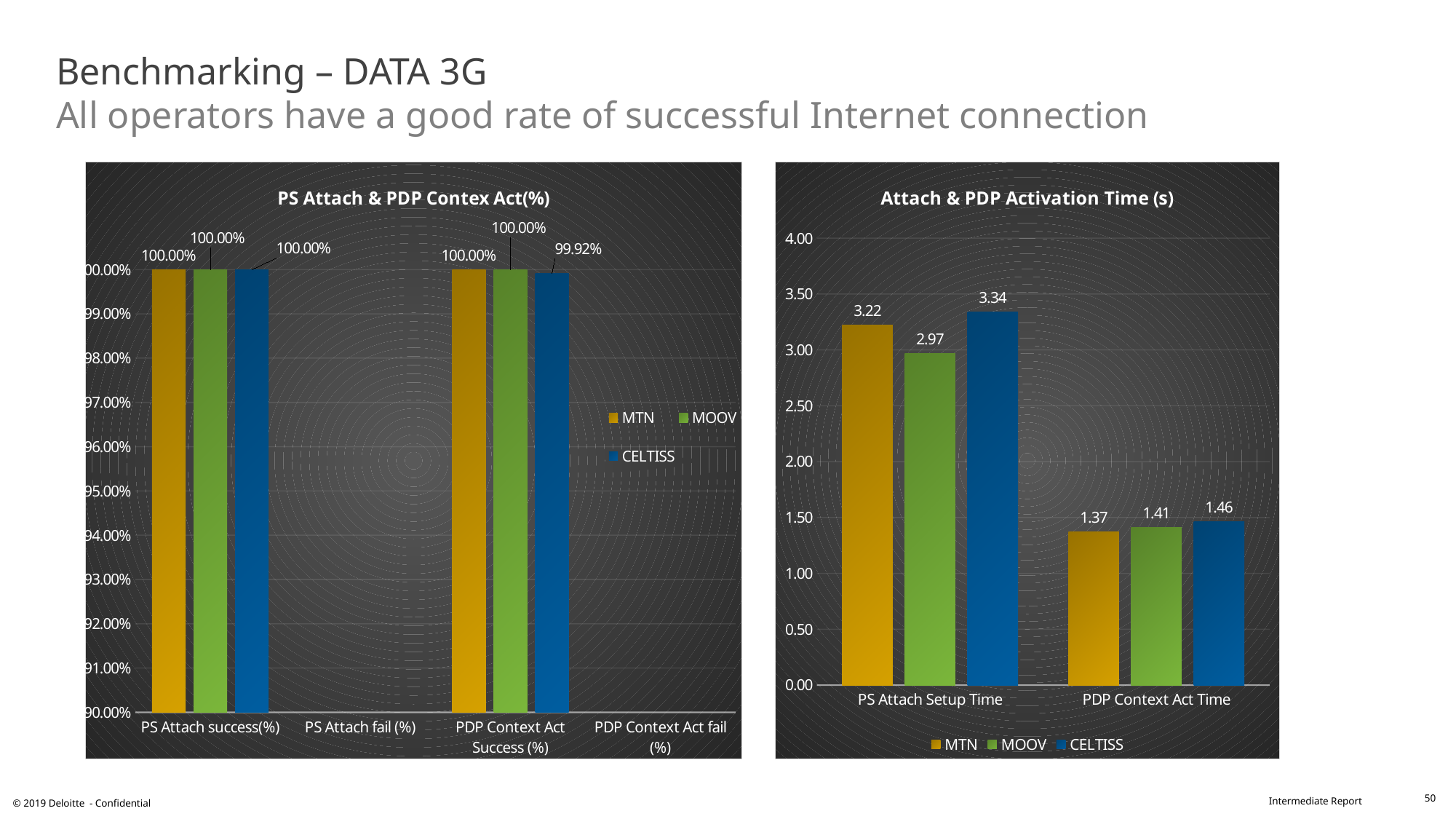
In the 'Attach & PDP Activation Time (s)' chart, which operator has the highest PS Attach Setup Time? CELTISS In the 'PS Attach & PDP Contex Act(%)' chart, what is the PS Attach success(%) value for MTN? 100.00% In the 'Attach & PDP Activation Time (s)' chart, is the PS Attach Setup Time for MTN greater or less than 3.00? greater In the 'Attach & PDP Activation Time (s)' chart, what is the PS Attach Setup Time for MOOV? 2.97 In the 'Attach & PDP Activation Time (s)' chart, which operator has the lowest PDP Context Act Time? MTN In the 'PS Attach & PDP Contex Act(%)' chart, what is the PDP Context Act Success (%) value for CELTISS? 99.92% In the 'PS Attach & PDP Contex Act(%)' chart, how many categories are shown on the x axis? 4 In the 'Attach & PDP Activation Time (s)' chart, how many series does the legend list? 3 What kind of chart is the 'Attach & PDP Activation Time (s)' chart? Bar chart In the 'Attach & PDP Activation Time (s)' chart, what is the difference between the PS Attach Setup Time of CELTISS and MOOV? 0.37 In the 'Attach & PDP Activation Time (s)' chart, what is the PDP Context Act Time for CELTISS? 1.46 In the 'PS Attach & PDP Contex Act(%)' chart, which operator has the lowest PDP Context Act Success (%)? CELTISS